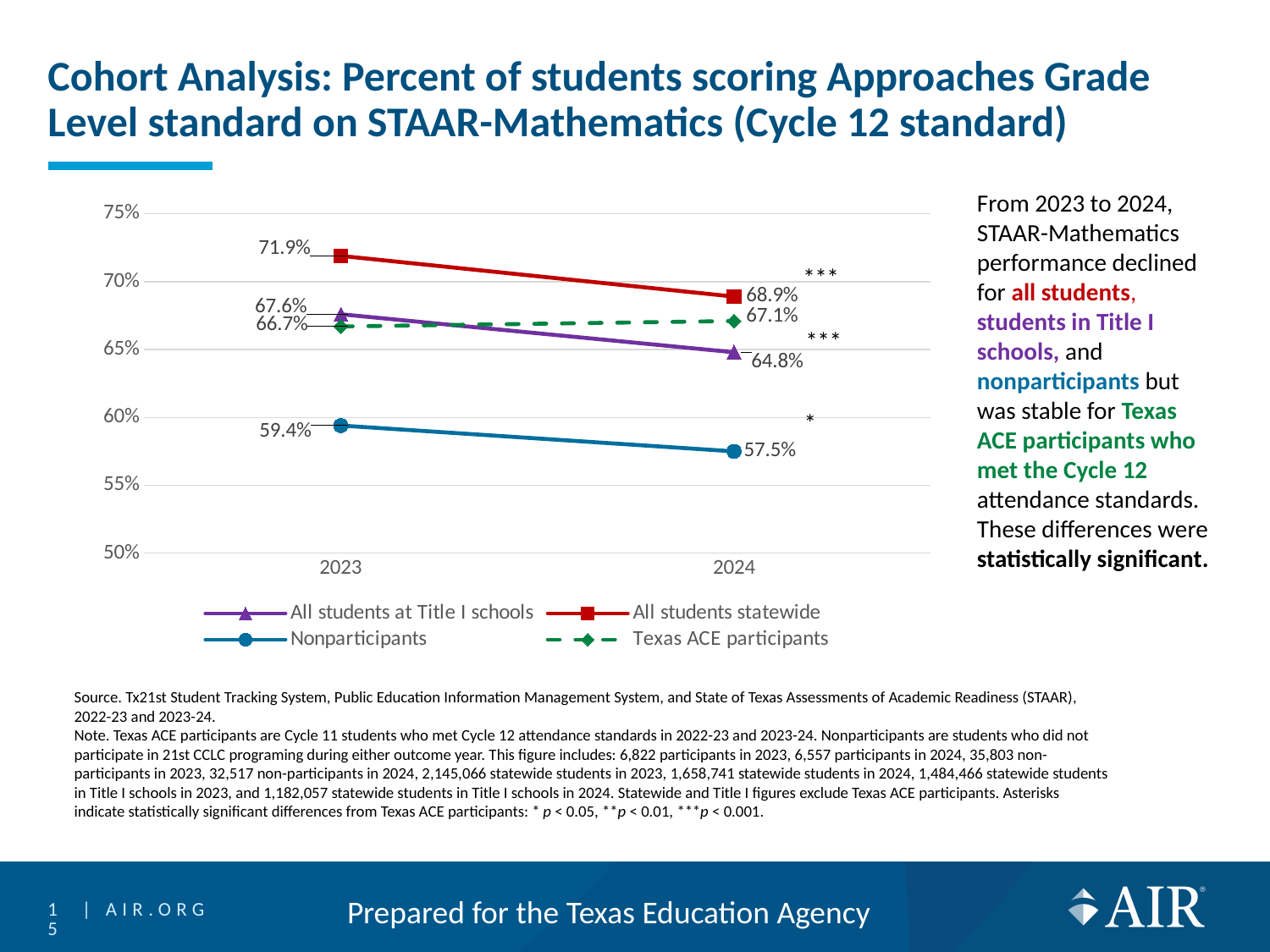
What was the value for Nonparticipants in 2024? 57.5% How many years are shown on the x axis? 2 Which series had the lowest value in 2023? Nonparticipants What is the difference between the All students statewide values in 2023 and 2024? 3.0% Which is larger in 2024: the value for All students at Title I schools or the value for Texas ACE participants? Texas ACE participants How many series does the legend list? 4 Did the value for Texas ACE participants rise or fall from 2023 to 2024? Rise Which series had the highest value in 2024? All students statewide What type of chart is shown on the slide? Line chart What was the value for All students statewide in 2023? 71.9% What was the value for Texas ACE participants in 2024? 67.1% What was the value for All students at Title I schools in 2023? 67.6%